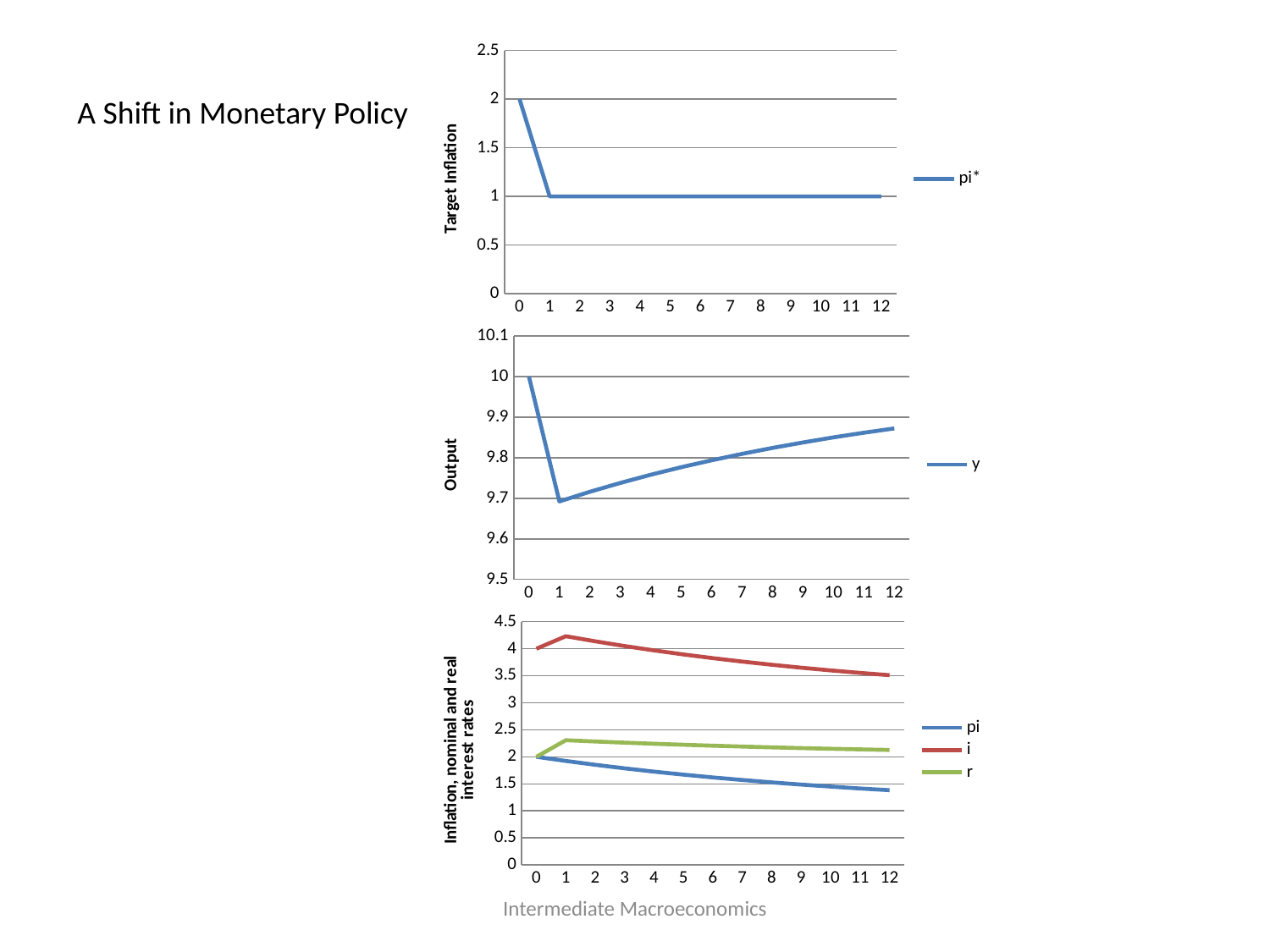
In the middle chart (Output), does y rise or fall from period 1 to period 12? rise In the bottom chart, is the value of pi at period 12 greater or less than 1.5? less In the bottom chart, which series is higher at period 12, i or pi? i In the middle chart (Output), what is the value of y at period 0? 10 In the middle chart (Output), at which period is y lowest? 1 In the top chart (Target Inflation), what is the value of pi* at period 12? 1 In the bottom chart, what is the value of i at period 0? 4 What kind of chart is the top chart (Target Inflation)? line chart In the middle chart (Output), is the value of y at period 12 greater or less than 9.8? greater In the top chart (Target Inflation), what is the difference between pi* at period 0 and pi* at period 1? 1 How many series does the legend of the bottom chart list? 3 In the top chart (Target Inflation), what is the value of pi* at period 0? 2